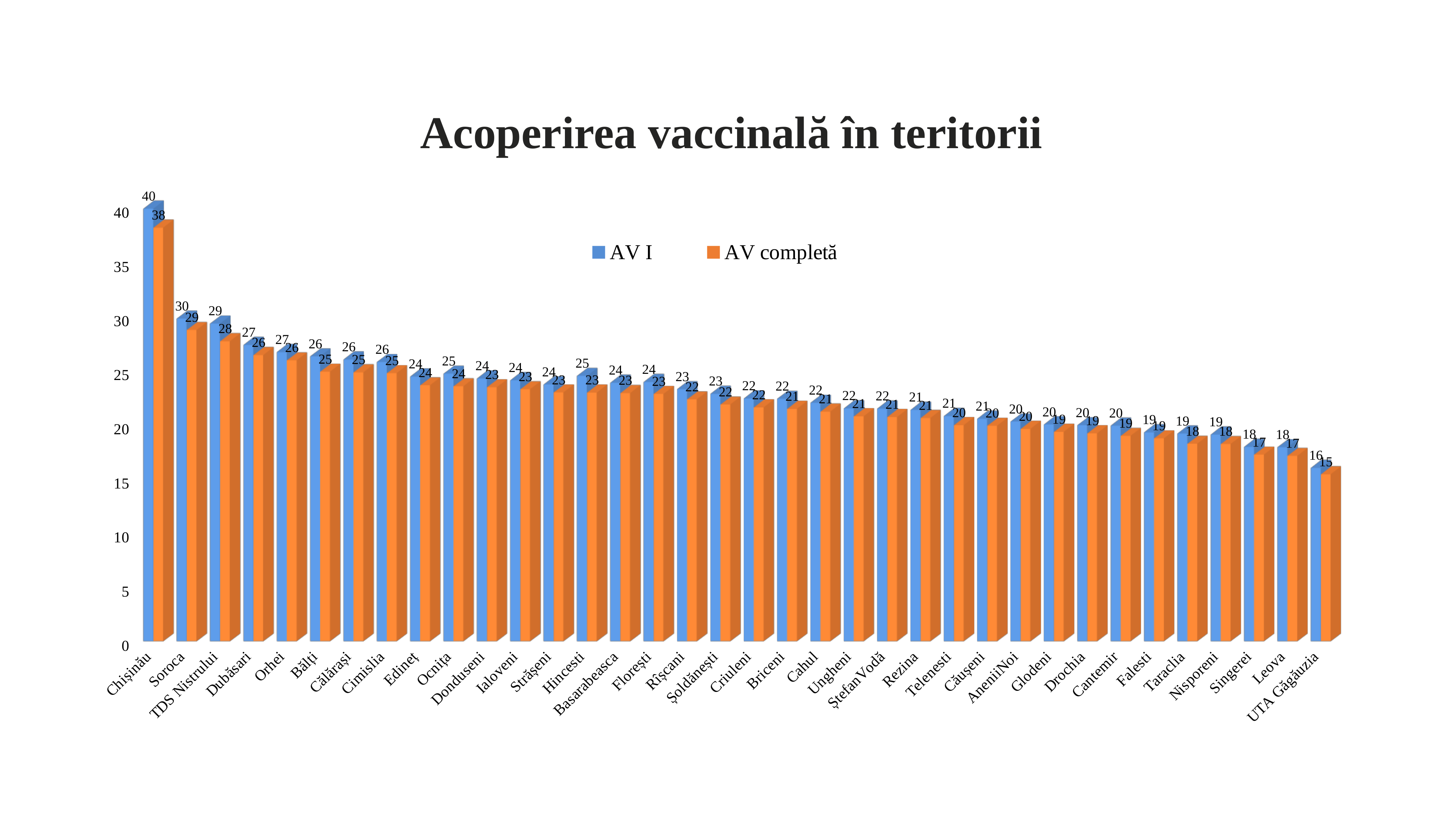
What kind of chart is shown on the slide? Bar chart What is the AV completă value for UTA Găgăuzia? 15 Do the AV I values rise or fall from left to right along the x axis? Fall How many territories are shown on the x axis? 36 What is the AV completă value for Soroca? 29 Which is larger, the AV I value for Soroca or the AV I value for TDS Nistrului? Soroca What is the AV I value for Hincesti? 25 What is the difference between the AV I and AV completă values for Chișinău? 2 Which territory has the lowest AV completă value? UTA Găgăuzia What is the AV I value for Chișinău? 40 How many series does the legend list? 2 Which territory has the highest AV I value? Chișinău